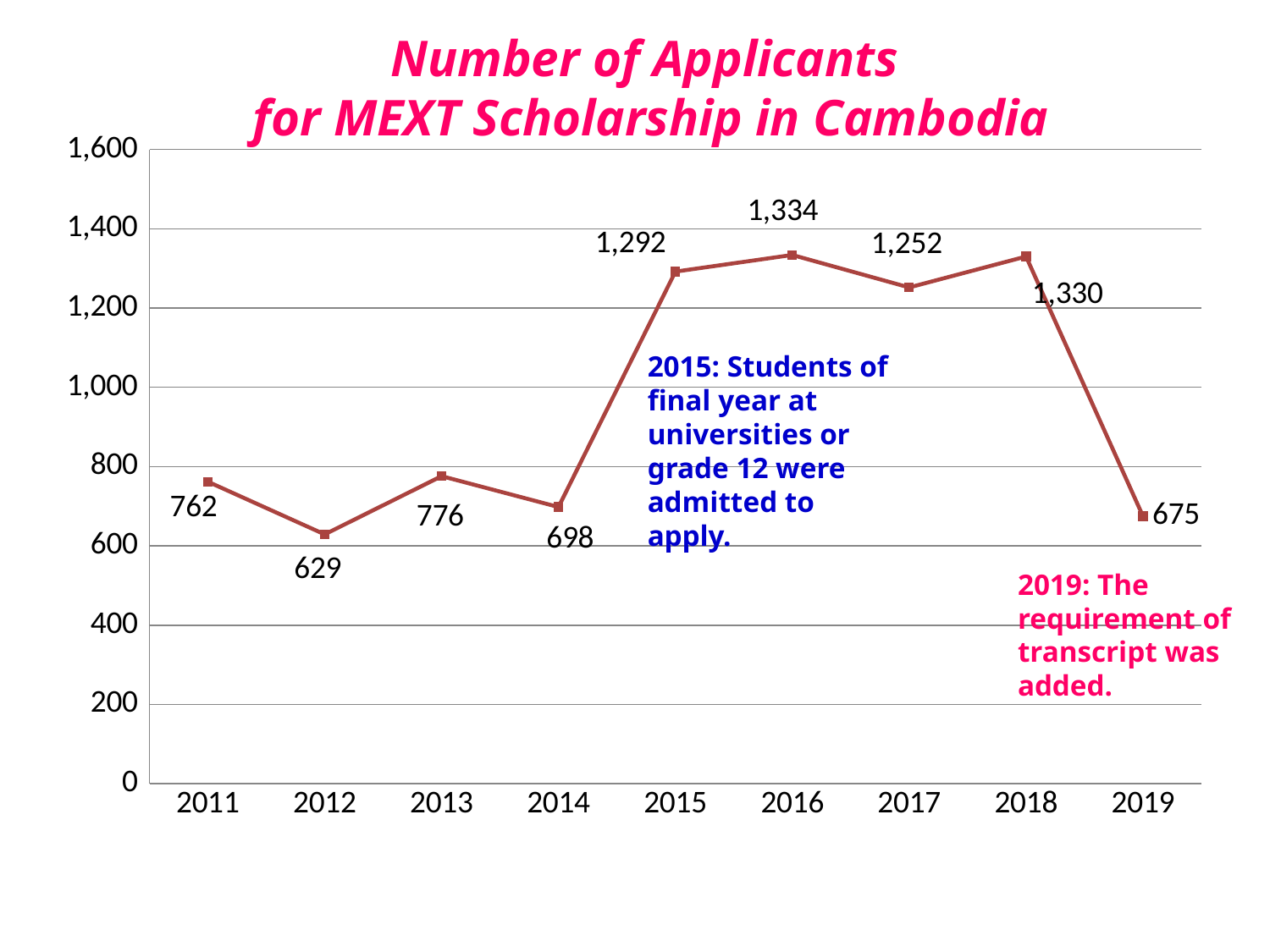
Which year has the highest number of applicants? 2016 What is the number of applicants in 2016? 1,334 What is the difference in the number of applicants between 2015 and 2014? 594 What is the title of the chart? Number of Applicants for MEXT Scholarship in Cambodia How many years are shown on the x axis? 9 Which year had more applicants, 2013 or 2017? 2017 What kind of chart is shown on the slide? line chart Which year has the lowest number of applicants? 2012 What is the number of applicants in 2019? 675 What is the difference in the number of applicants between 2018 and 2019? 655 Is the number of applicants in 2011 greater or less than 800? less What is the number of applicants in 2012? 629